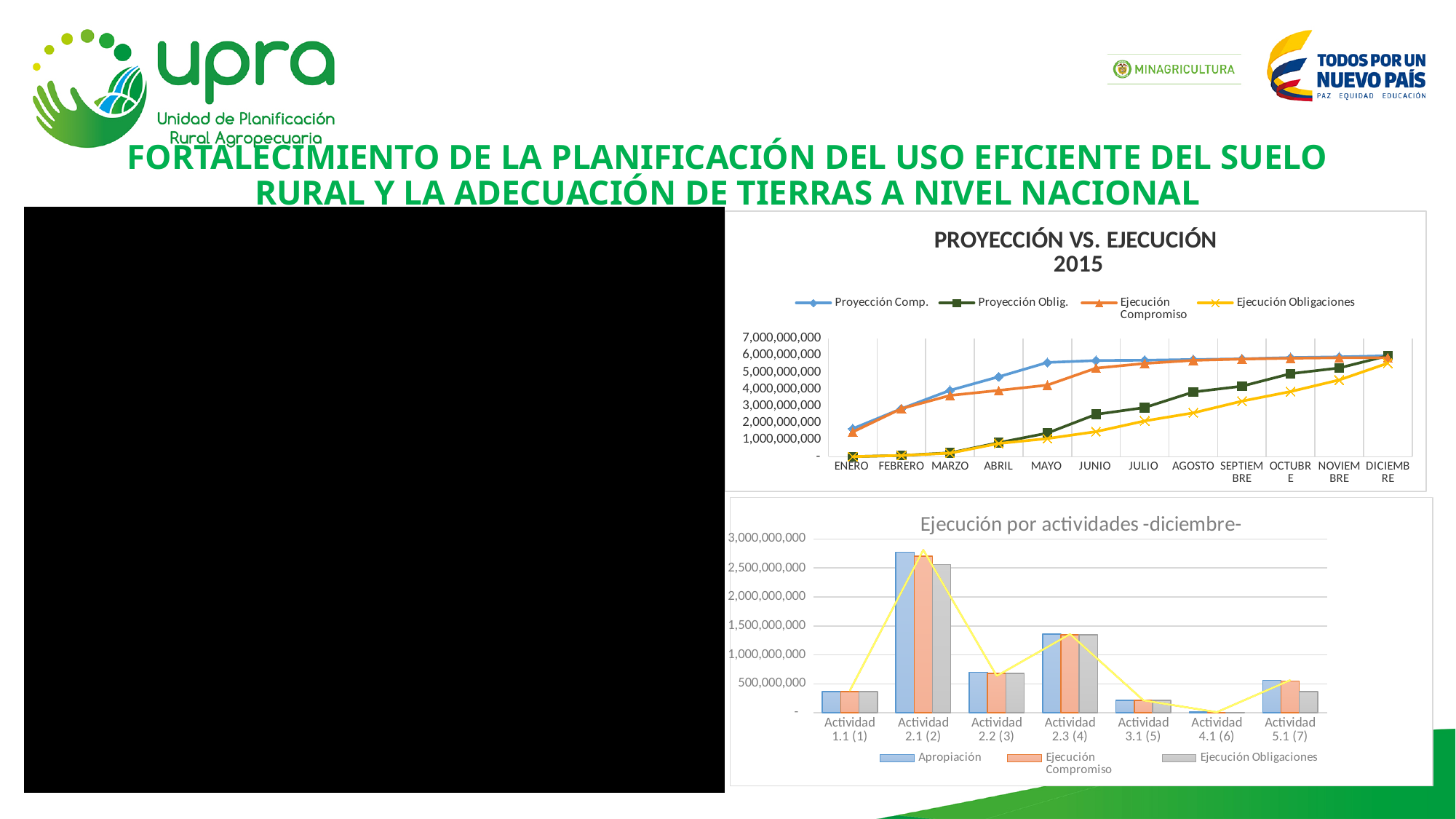
How many series does the legend of the 'PROYECCIÓN VS. EJECUCIÓN 2015' chart list? 4 What kind of chart is the 'PROYECCIÓN VS. EJECUCIÓN 2015' chart? line chart In the 'Ejecución por actividades -diciembre-' chart, which is larger, the Apropiación value for Actividad 2.2 (3) or for Actividad 3.1 (5)? Actividad 2.2 (3) What kind of chart is the 'Ejecución por actividades -diciembre-' chart? combination bar and line chart In the 'PROYECCIÓN VS. EJECUCIÓN 2015' chart, is the value of Proyección Comp. in MAYO greater or less than 5,000,000,000? greater In the 'PROYECCIÓN VS. EJECUCIÓN 2015' chart, does the Proyección Comp. series rise or fall from ENERO to DICIEMBRE? rise In the 'PROYECCIÓN VS. EJECUCIÓN 2015' chart, which series has the lowest value in JUNIO? Ejecución Obligaciones In the 'Ejecución por actividades -diciembre-' chart, which activity has the highest Apropiación value? Actividad 2.1 (2) In the 'PROYECCIÓN VS. EJECUCIÓN 2015' chart, is the value of Ejecución Compromiso in MARZO greater or less than 3,000,000,000? greater How many months are shown on the x axis of the 'PROYECCIÓN VS. EJECUCIÓN 2015' chart? 12 How many activities are shown on the x axis of the 'Ejecución por actividades -diciembre-' chart? 7 In the 'Ejecución por actividades -diciembre-' chart, is the Apropiación value for Actividad 2.3 (4) greater or less than 1,000,000,000? greater